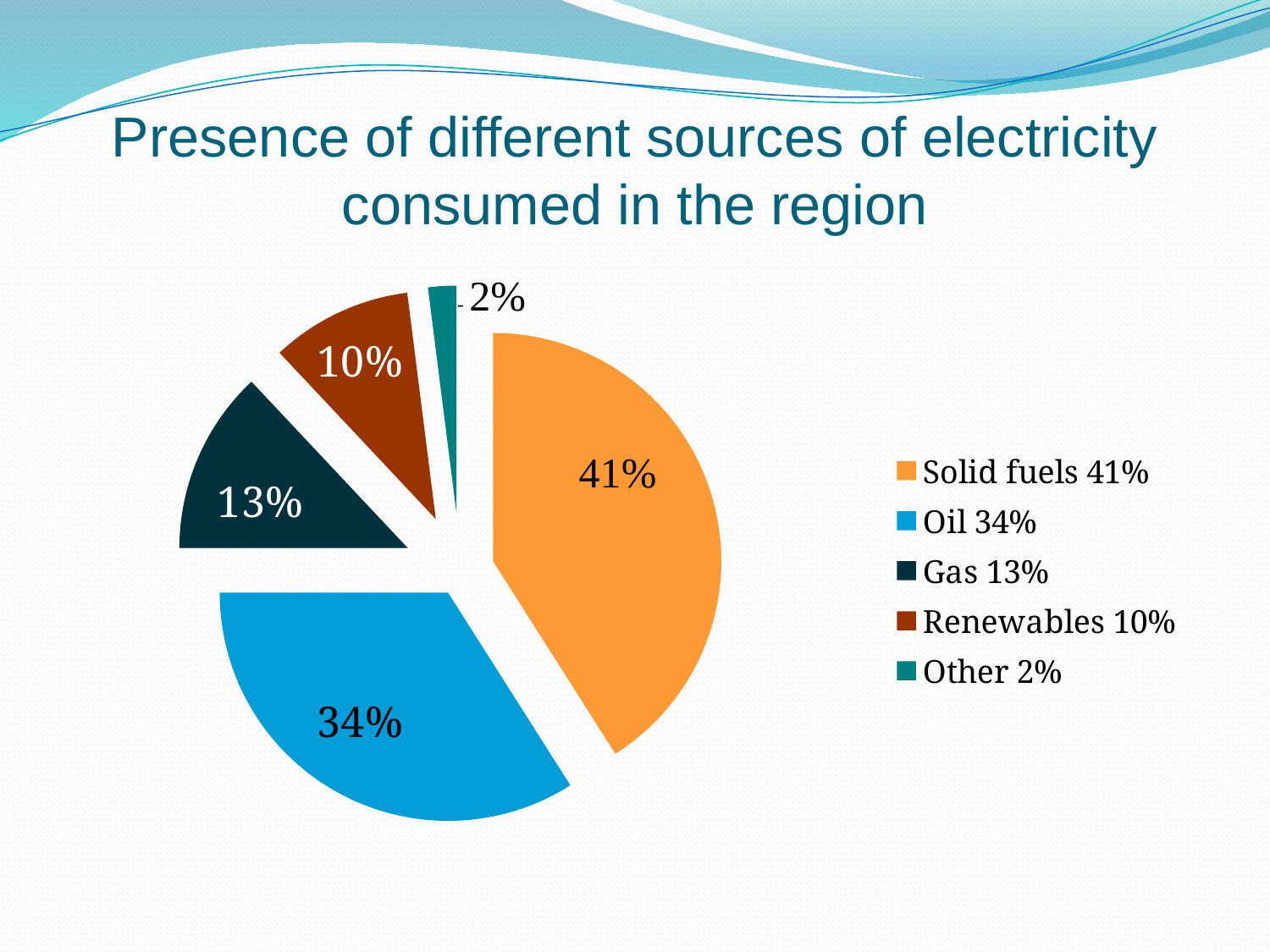
What is the difference in percentage points between Solid fuels and Oil? 7 Which source of electricity has the largest share in the pie chart? Solid fuels What kind of chart is shown on the slide? pie chart What is the value shown for Gas? 13% What is the value for the Other category? 2% How many categories are shown in the pie chart? 5 Which category has the smallest slice in the pie chart? Other Which is larger, the share for Gas or the share for Renewables? Gas What percentage does the Oil slice represent? 34% What is the title of the chart on the slide? Presence of different sources of electricity consumed in the region What percentage is shown for Renewables? 10% What share of electricity consumed in the region comes from solid fuels? 41%